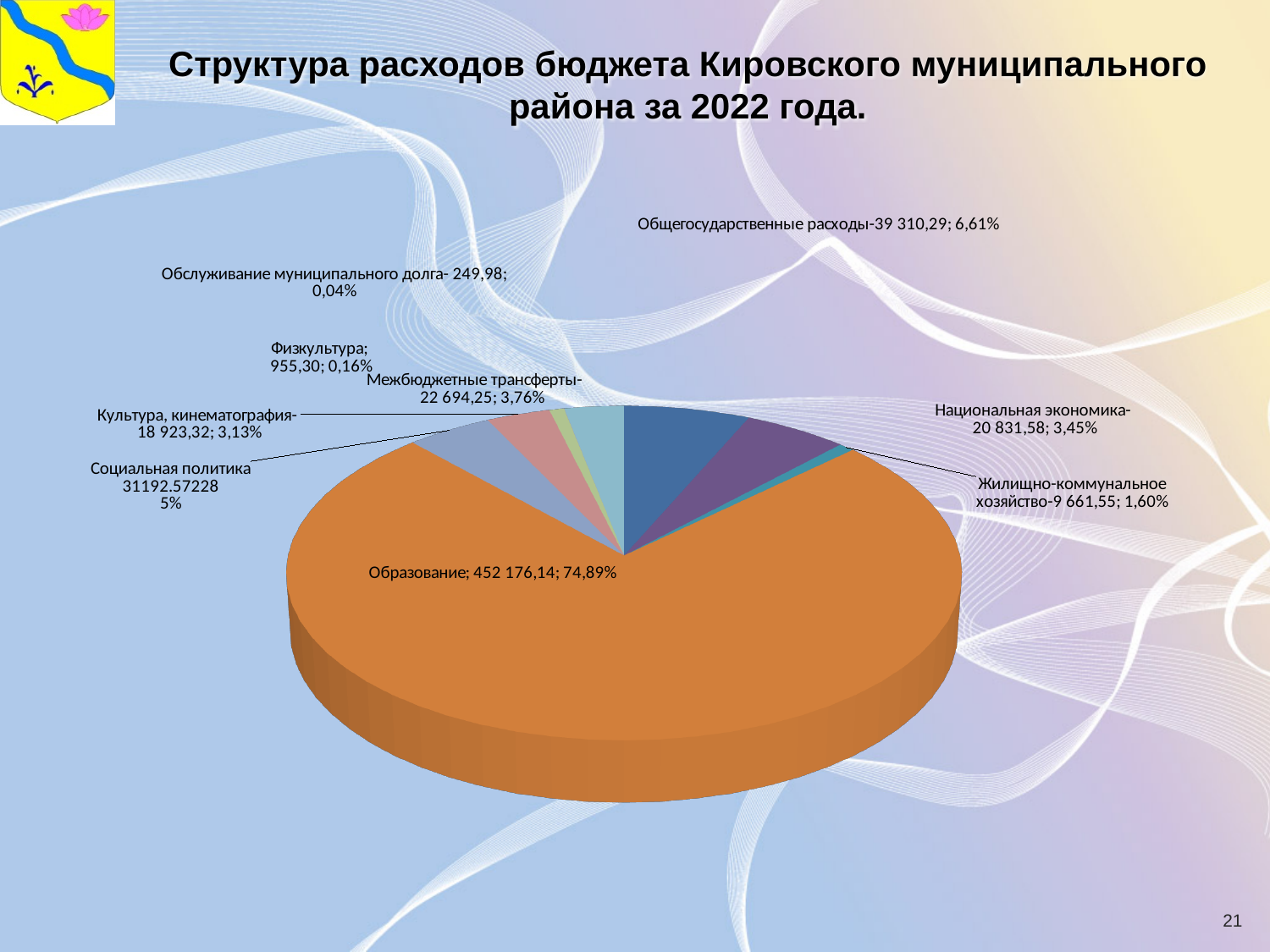
How many categories (slices) does the pie chart show? 9 What is the title of the chart on the slide? Структура расходов бюджета Кировского муниципального района за 2022 года. What is the value shown for Физкультура? 955,30 Which category has the largest slice of the pie chart? Образование What share of the pie does Образование represent? 74,89% What share of the pie does Жилищно-коммунальное хозяйство represent? 1,60% What is the value shown for Национальная экономика? 20 831,58 What type of chart is shown on the slide? Pie chart What is the value shown for Общегосударственные расходы? 39 310,29 What is the difference between the values for Общегосударственные расходы and Национальная экономика? 18 478,71 Which category has the smallest slice of the pie chart? Обслуживание муниципального долга Which is larger: Межбюджетные трансферты or Культура, кинематография? Межбюджетные трансферты